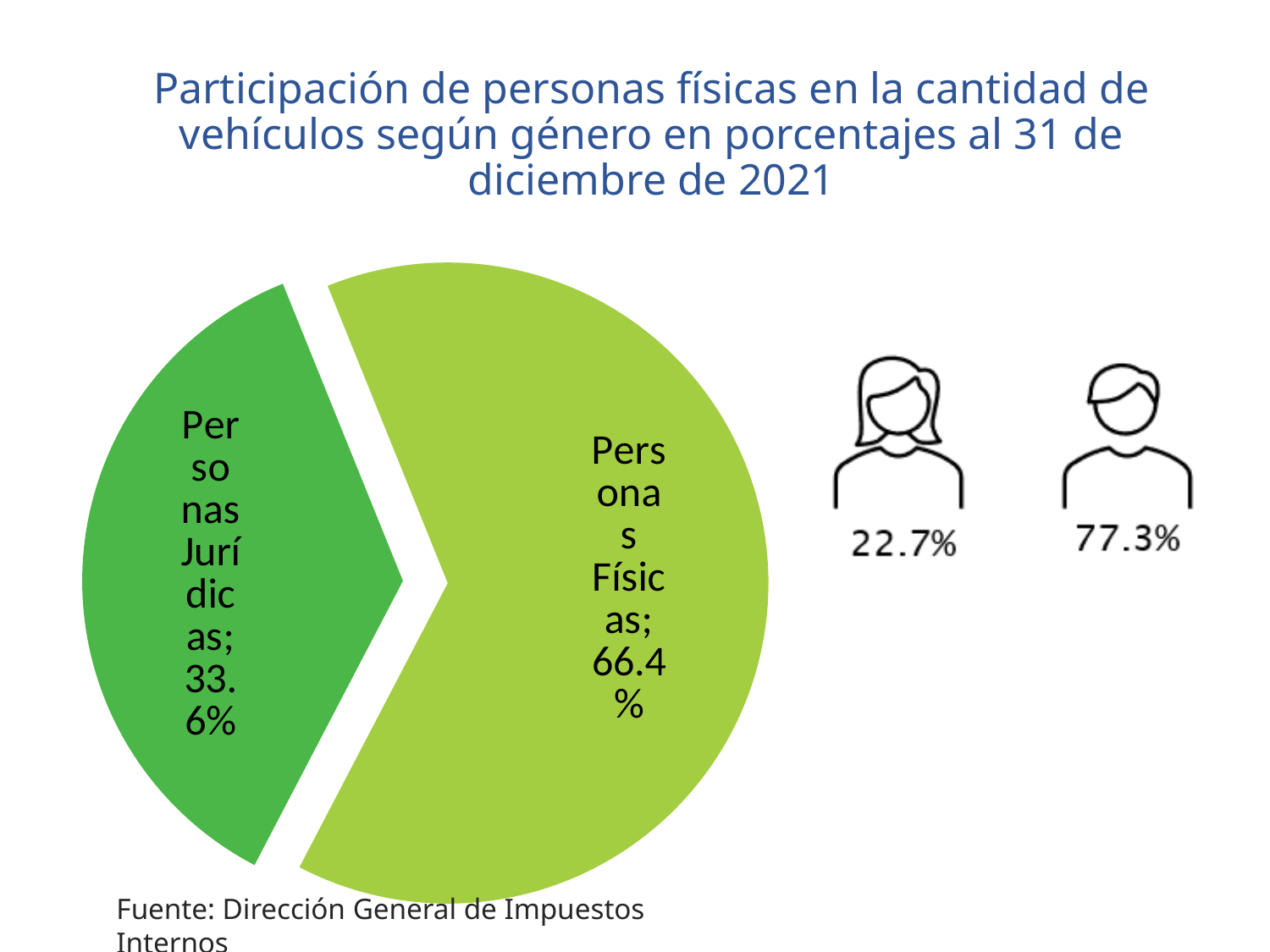
What is the combined total of the two slices in the pie chart? 100% What source is cited below the pie chart? Dirección General de Impuestos Internos Which slice of the pie chart is the largest? Personas Físicas What kind of chart is shown on the slide? Pie chart What share of the pie does the Personas Jurídicas slice represent? 33.6% Which slice of the pie chart is the smallest? Personas Jurídicas Which is larger in the pie chart, Personas Físicas or Personas Jurídicas? Personas Físicas What is the difference in percentage points between the Personas Físicas slice and the Personas Jurídicas slice? 32.8 How many slices does the pie chart have? 2 What percentage does the pie chart show for Personas Jurídicas? 33.6% What percentage does the pie chart show for Personas Físicas? 66.4% What is the title of the chart on the slide? Participación de personas físicas en la cantidad de vehículos según género en porcentajes al 31 de diciembre de 2021